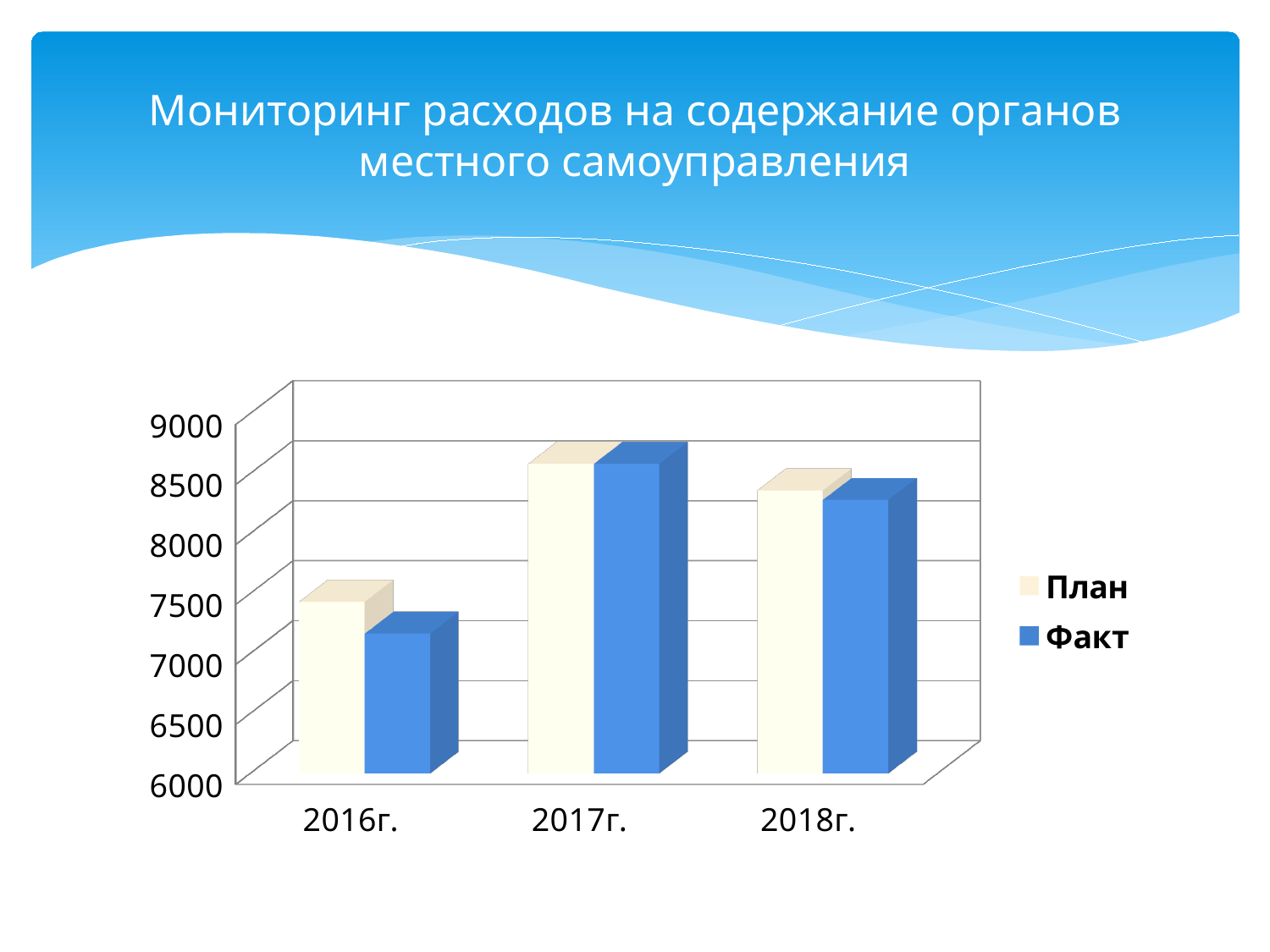
How many year categories are shown on the x axis? 3 Is the value for Факт in 2018г. greater or less than 8500? less What kind of chart is shown on the slide? bar chart Is the value for План in 2017г. greater or less than 8500? greater In 2016г., which is larger, План or Факт? План Which year has the highest value for План? 2017г. Is the value for План in 2018г. greater or less than 8000? greater How many series does the legend list? 2 Which year has the lowest value for Факт? 2016г. Which year has the lowest value for План? 2016г. What are the names of the two series in the legend? План, Факт